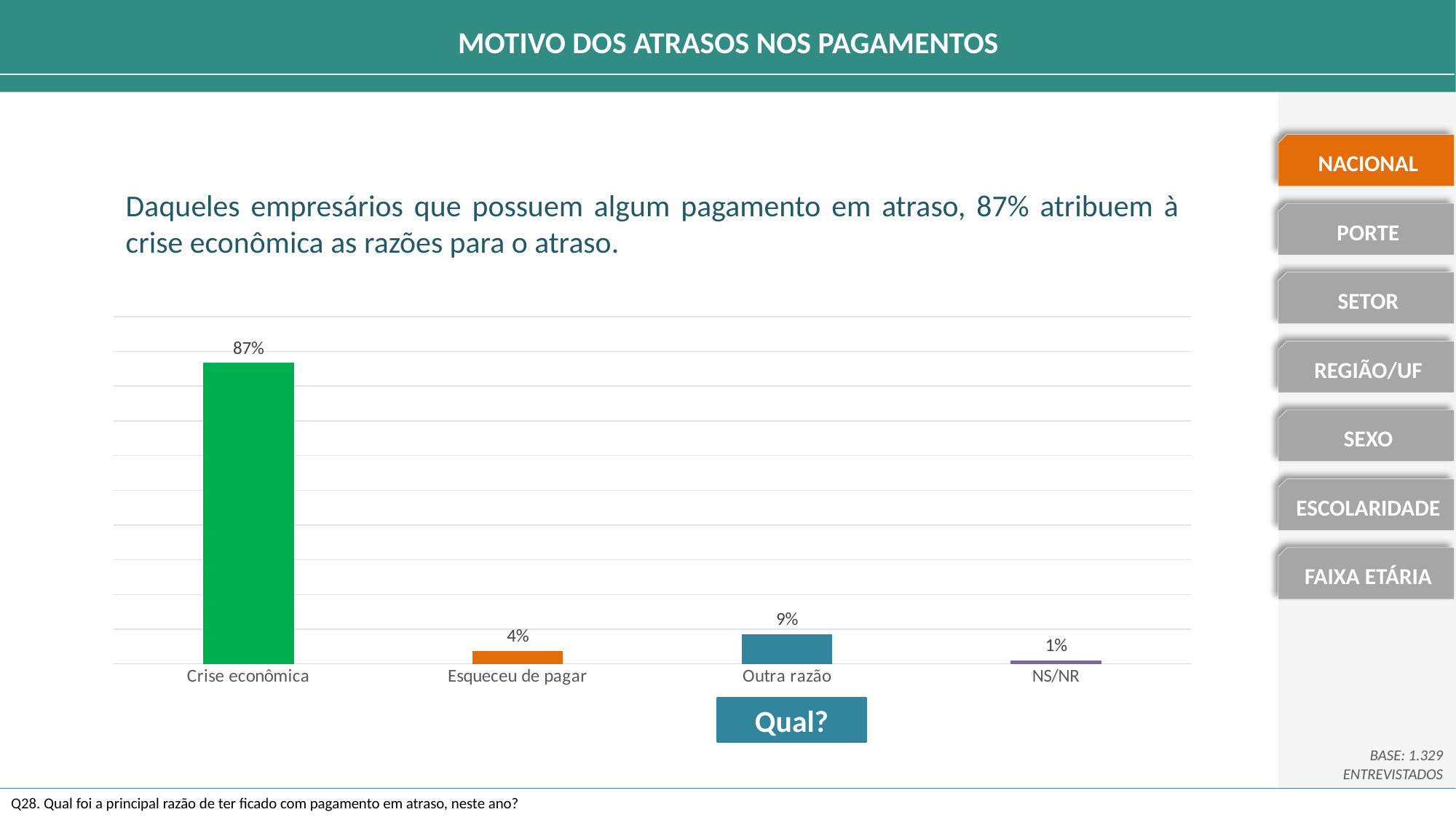
Which is larger, the value for Esqueceu de pagar or the value for Outra razão? Outra razão What is the value for NS/NR? 1% What is the value for Outra razão? 9% Which category has the highest value? Crise econômica What is the difference between the values for Crise econômica and Outra razão? 78% What kind of chart is shown on the slide? Bar chart What is the value for Esqueceu de pagar? 4% What is the difference between the values for Outra razão and Esqueceu de pagar? 5% How many categories are shown in the chart? 4 What is the title of the slide containing the chart? MOTIVO DOS ATRASOS NOS PAGAMENTOS What is the value for Crise econômica? 87% Which category has the lowest value? NS/NR